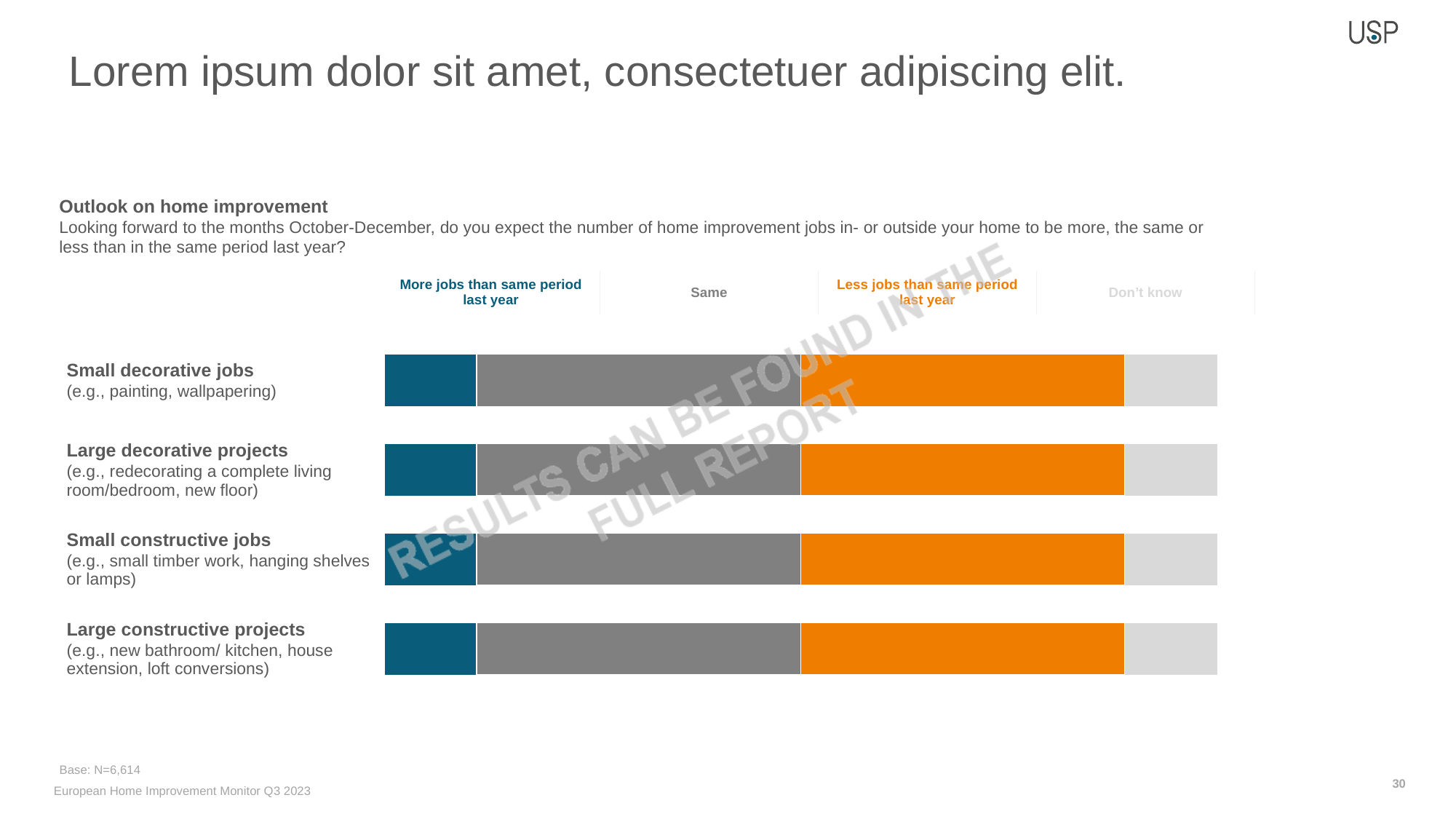
How many job categories are plotted in the chart? 4 How many response options (series) does the chart header list? 4 Which response option is shown in orange? Less jobs than same period last year What kind of chart is shown on the slide? stacked bar chart For Large decorative projects, which segment is larger: 'More jobs than same period last year' or 'Less jobs than same period last year'? Less jobs than same period last year For Large constructive projects, which segment is larger: 'Less jobs than same period last year' or 'Don't know'? Less jobs than same period last year What is the base (sample size) stated below the chart? N=6,614 Which response option is shown in dark blue? More jobs than same period last year For Small decorative jobs, which segment is larger: 'Same' or 'More jobs than same period last year'? Same